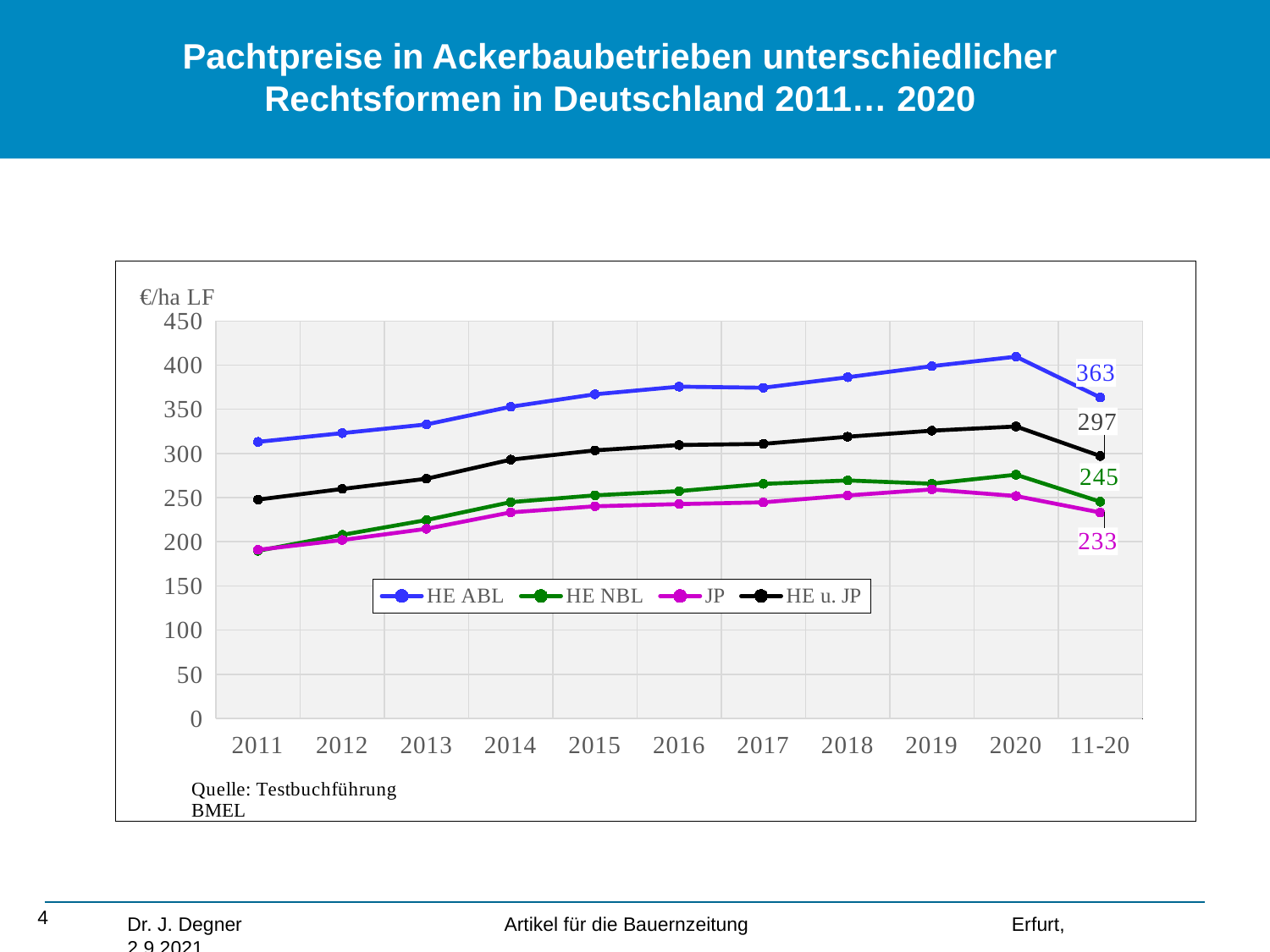
Which series has the highest value in 2020? HE ABL What is the difference between the HE ABL and JP values at the 11-20 point? 130 How many series does the legend list? 4 At the 11-20 point, which is larger: HE NBL or JP? HE NBL What is the value for HE ABL at the 11-20 point? 363 What kind of chart is shown on the slide? line chart Is the value for HE ABL in 2020 greater or less than 400? greater What is the value for JP at the 11-20 point? 233 Does the HE ABL line rise or fall from 2011 to 2020? rise What is the value for HE u. JP at the 11-20 point? 297 What is the value for HE NBL at the 11-20 point? 245 What unit is shown on the y axis of the chart? €/ha LF